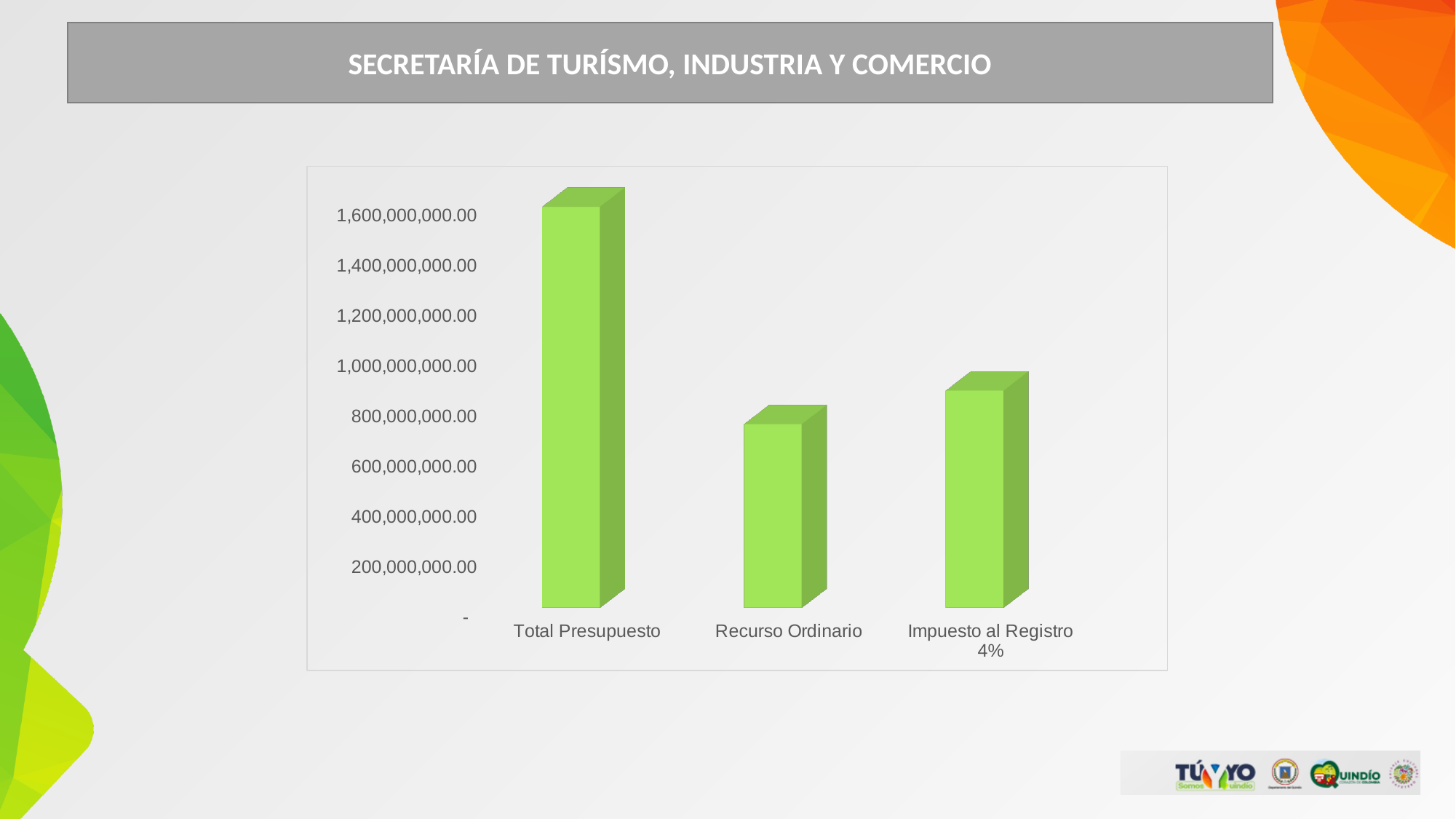
Which category has the lowest value in the chart? Recurso Ordinario What kind of chart is shown on the slide? bar chart Is the value for Recurso Ordinario greater or less than 600,000,000.00? greater Which category has the highest value in the chart? Total Presupuesto Is the value for Total Presupuesto greater or less than 1,400,000,000.00? greater What colour are the bars in the chart? green Which is larger, the value for Recurso Ordinario or the value for Impuesto al Registro 4%? Impuesto al Registro 4% Is the value for Impuesto al Registro 4% greater or less than 800,000,000.00? greater How many categories are plotted in the chart? 3 What is the title shown in the banner at the top of the slide? SECRETARÍA DE TURÍSMO, INDUSTRIA Y COMERCIO